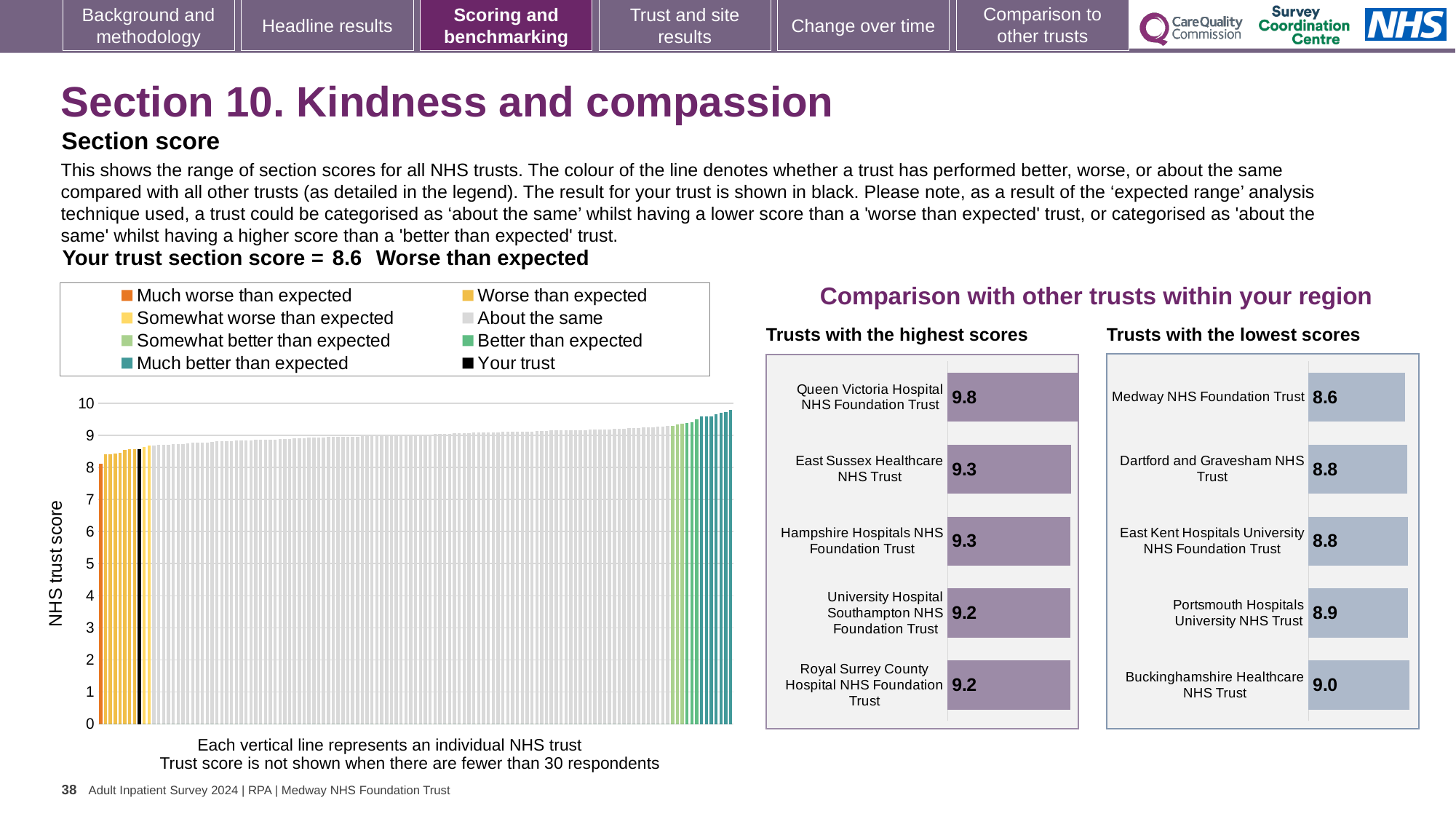
What kind of chart is the large chart on the left showing NHS trust scores? Bar chart In the 'Trusts with the lowest scores' chart, which trust has the lowest score? Medway NHS Foundation Trust In the 'Trusts with the highest scores' chart, what is the difference between the scores of Queen Victoria Hospital NHS Foundation Trust and Royal Surrey County Hospital NHS Foundation Trust? 0.6 In the 'Trusts with the lowest scores' chart, what is the difference between the scores of Buckinghamshire Healthcare NHS Trust and Medway NHS Foundation Trust? 0.4 How many trusts are shown in the 'Trusts with the highest scores' chart? 5 In the large 'NHS trust score' chart on the left, do the bar values rise or fall from left to right along the x axis? Rise In the 'Trusts with the highest scores' chart, which trust has the highest score? Queen Victoria Hospital NHS Foundation Trust In the large 'NHS trust score' chart on the left, is the value of the black bar (Your trust) greater or less than 9? less In the 'Trusts with the lowest scores' chart, what is the score for Medway NHS Foundation Trust? 8.6 In the 'Trusts with the highest scores' chart, what is the score for Queen Victoria Hospital NHS Foundation Trust? 9.8 How many entries does the legend of the large 'NHS trust score' chart on the left list? 8 In the 'Trusts with the lowest scores' chart, which has the higher score: Portsmouth Hospitals University NHS Trust or Dartford and Gravesham NHS Trust? Portsmouth Hospitals University NHS Trust